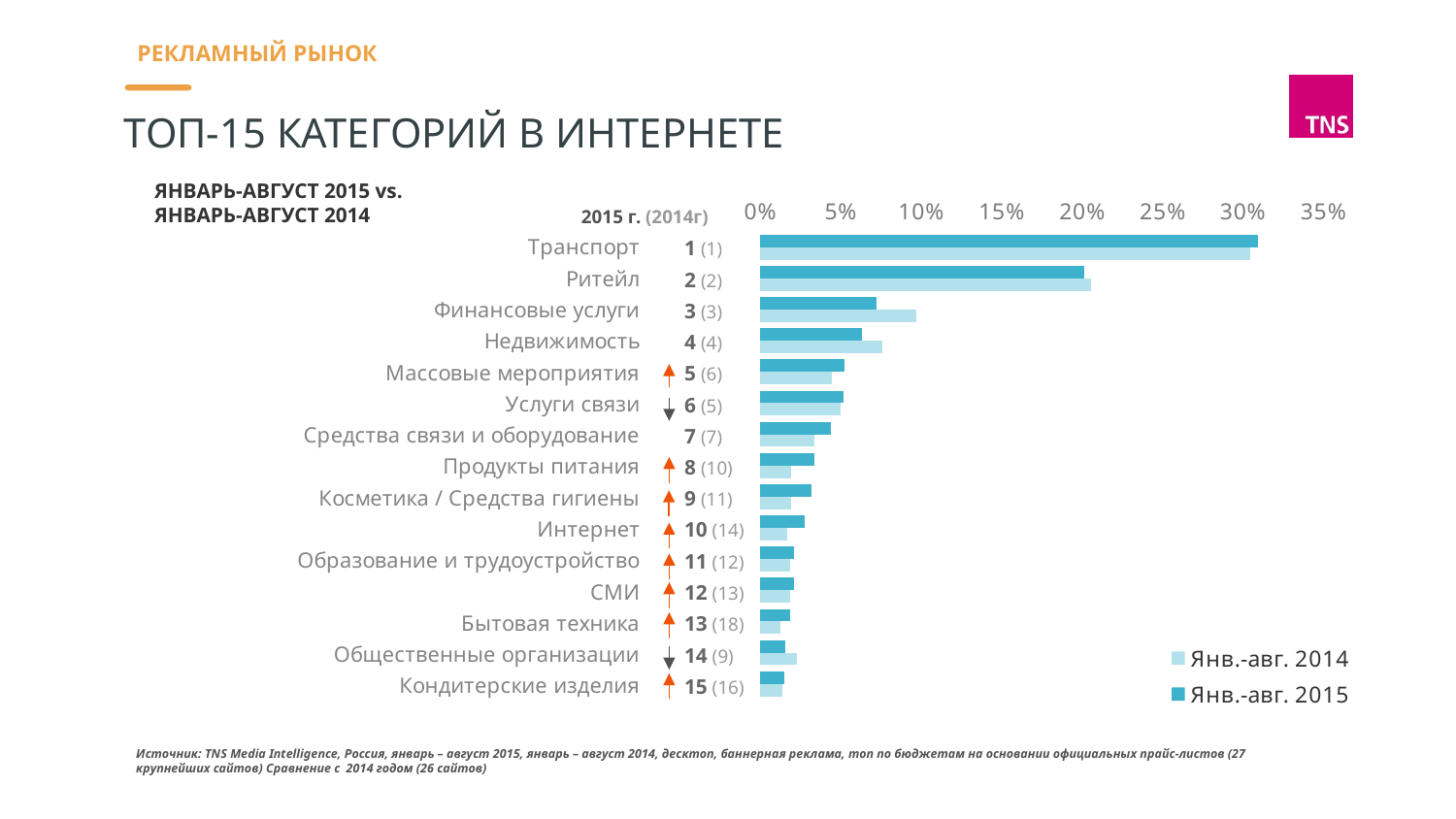
Is the Янв.-авг. 2015 value for Ритейл greater or less than 15%? greater Which is larger for Финансовые услуги: the Янв.-авг. 2014 value or the Янв.-авг. 2015 value? Янв.-авг. 2014 What kind of chart is shown on the slide? Bar chart How many series does the legend list? 2 What was the 2014 rank of Интернет, as shown in parentheses next to the category? 14 Is the Янв.-авг. 2015 value for Финансовые услуги greater or less than 10%? less How many categories are plotted in the chart? 15 What are the two series named in the legend? Янв.-авг. 2014 and Янв.-авг. 2015 Is the Янв.-авг. 2015 value for Продукты питания greater or less than 5%? less Which category has the highest value in the chart? Транспорт Which is larger for Интернет: the Янв.-авг. 2014 value or the Янв.-авг. 2015 value? Янв.-авг. 2015